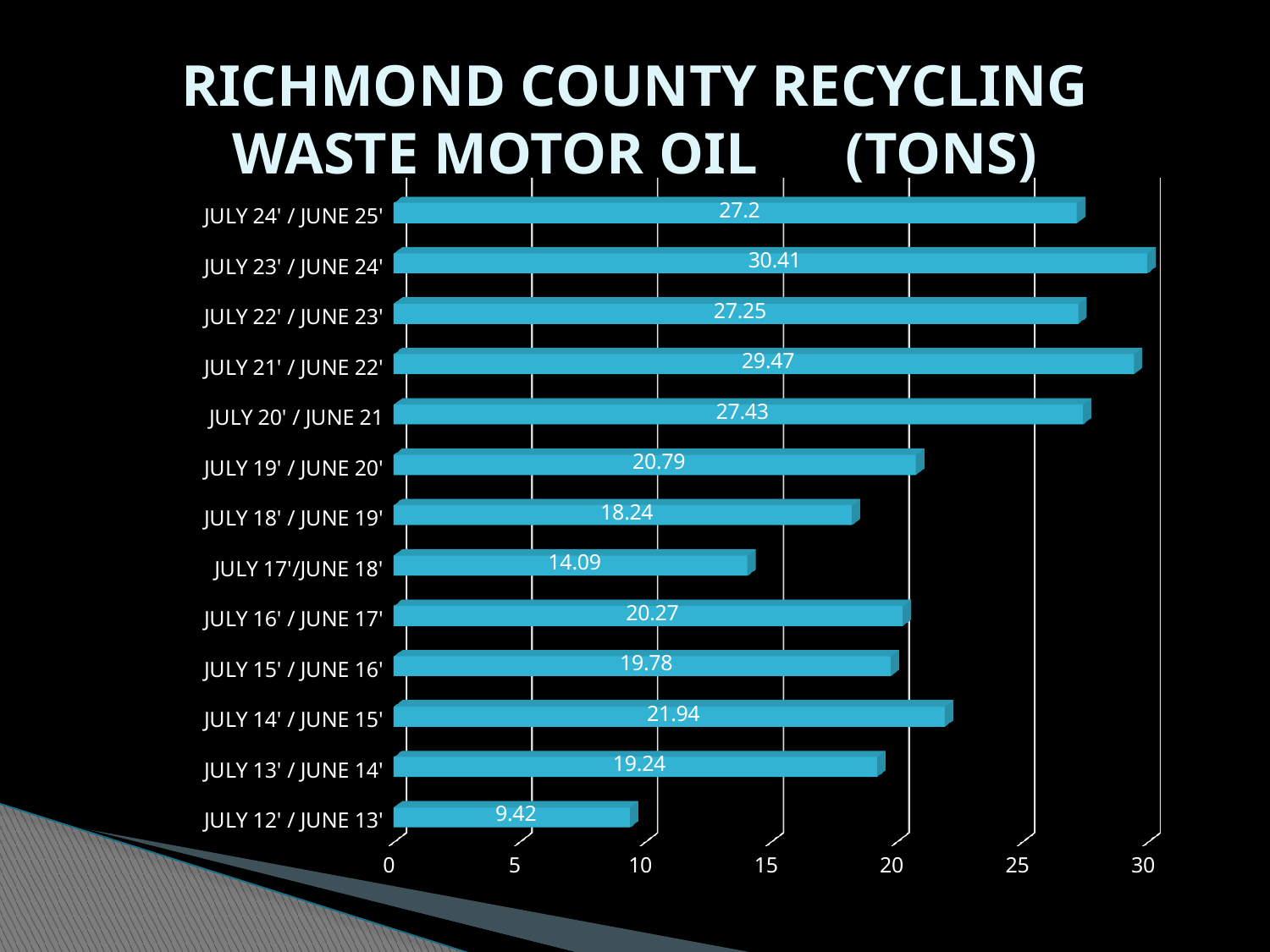
What is the title of the chart? RICHMOND COUNTY RECYCLING WASTE MOTOR OIL (TONS) What is the difference between the values for JULY 23' / JUNE 24' and JULY 22' / JUNE 23'? 3.16 What is the value for JULY 12' / JUNE 13'? 9.42 Which category has the highest value? JULY 23' / JUNE 24' Which is larger, the value for JULY 21' / JUNE 22' or the value for JULY 20' / JUNE 21? JULY 21' / JUNE 22' Is the value for JULY 14' / JUNE 15' greater or less than 20? greater How many categories are shown in the chart? 13 What kind of chart is shown on the slide? bar chart What is the value for JULY 17'/JUNE 18'? 14.09 What is the value for JULY 24' / JUNE 25'? 27.2 Which category has the lowest value? JULY 12' / JUNE 13' What is the difference between the values for JULY 13' / JUNE 14' and JULY 12' / JUNE 13'? 9.82